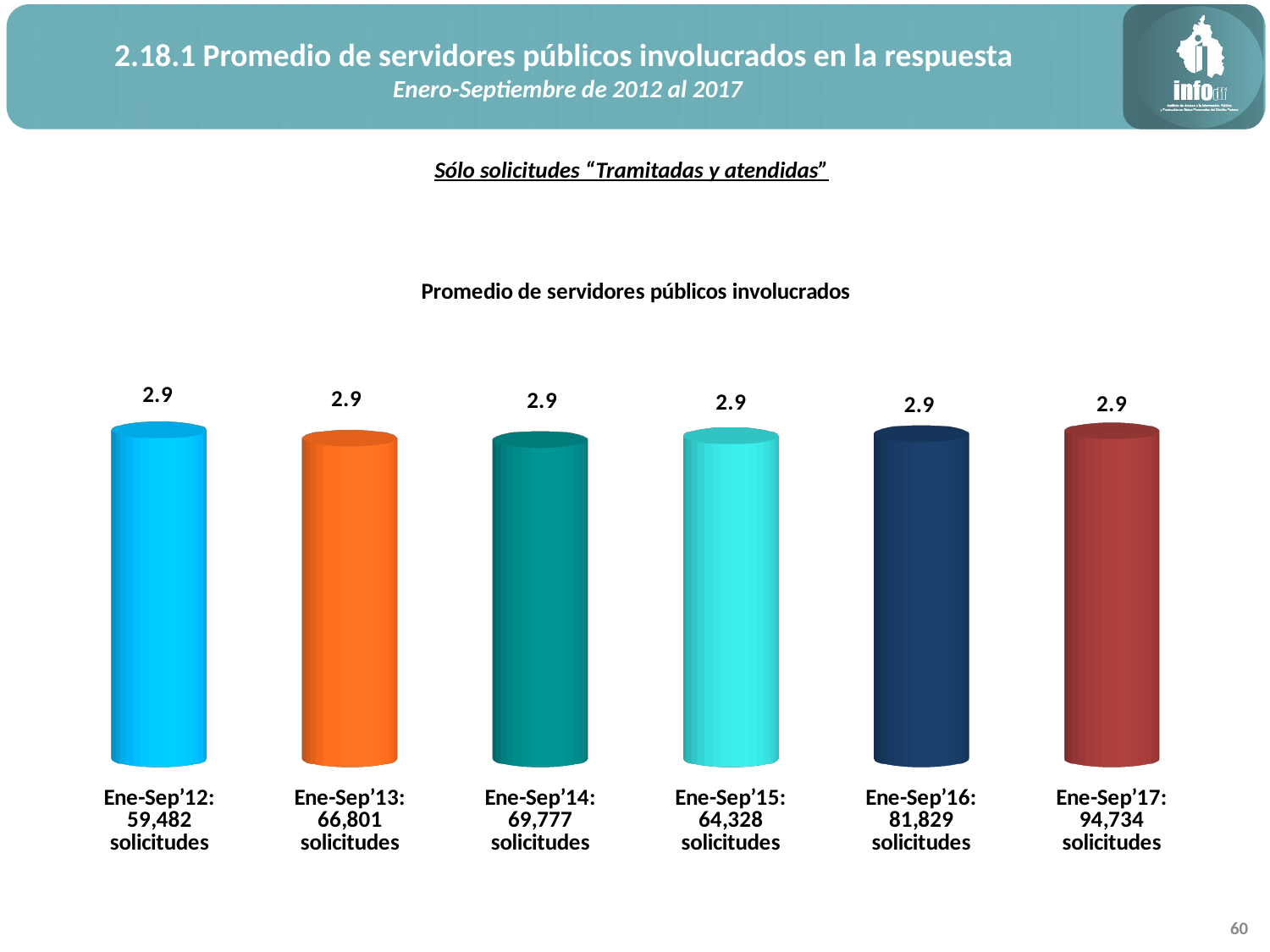
How many bars (categories) are shown in the chart? 6 Do the values rise, fall, or stay the same from Ene-Sep'12 to Ene-Sep'17? Stay the same What is the value for Ene-Sep'17 in the chart? 2.9 What is the title of the chart? Promedio de servidores públicos involucrados How many solicitudes are listed in the category label for Ene-Sep'14? 69,777 solicitudes How many solicitudes are listed in the category label for Ene-Sep'17? 94,734 solicitudes What kind of chart is shown on the slide? Bar chart What is the value for Ene-Sep'12 in the chart? 2.9 What colour is the bar for Ene-Sep'13? Orange What is the difference between the values for Ene-Sep'16 and Ene-Sep'13? 0 What is the value for Ene-Sep'15 in the chart? 2.9